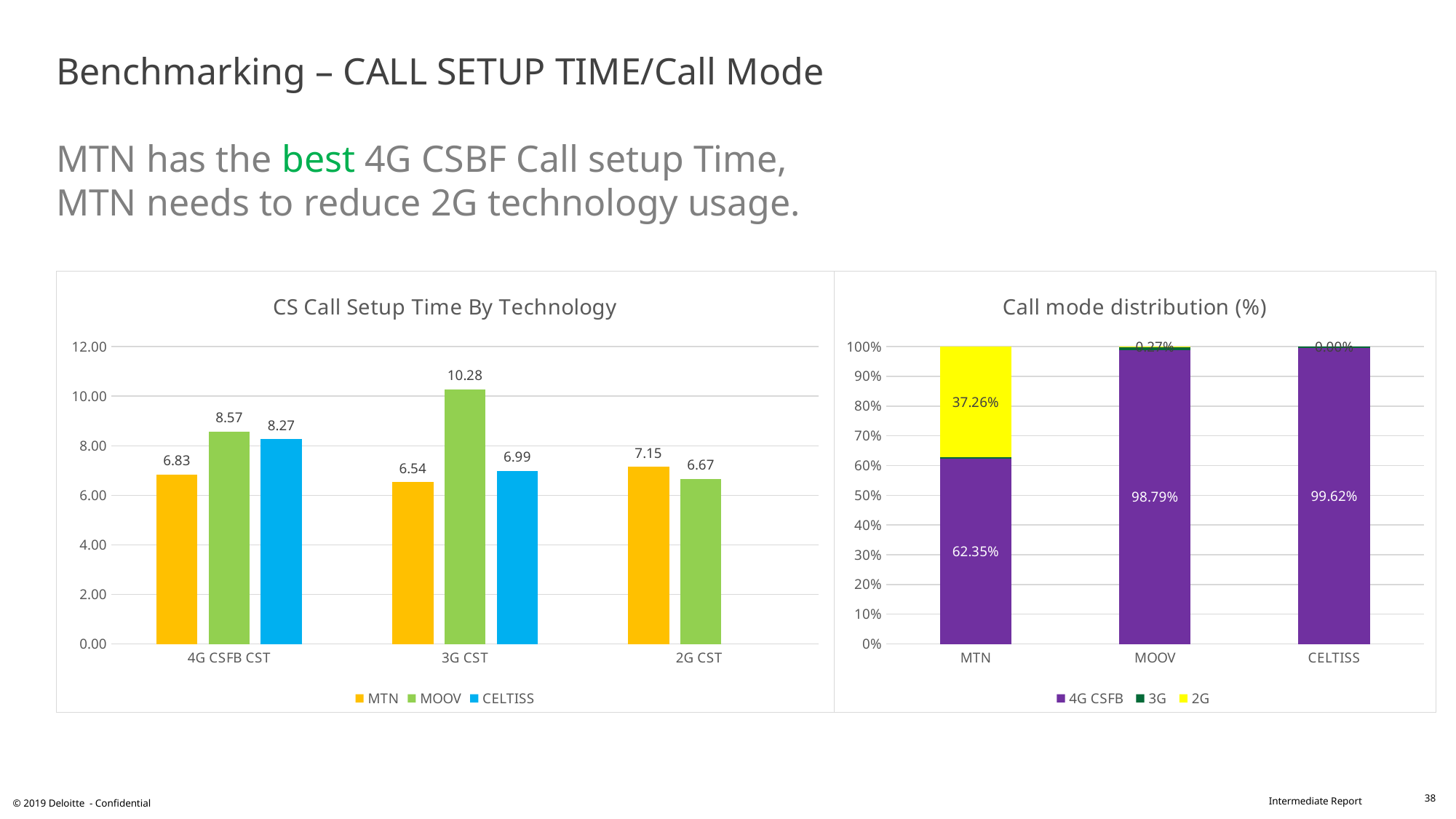
How many series does the legend of the 'CS Call Setup Time By Technology' chart list? 3 In the 'CS Call Setup Time By Technology' chart, which operator has the highest value in the 3G CST category? MOOV In the 'CS Call Setup Time By Technology' chart, which is larger in the 2G CST category: MTN or MOOV? MTN In the 'CS Call Setup Time By Technology' chart, what is the value for MTN in the 4G CSFB CST category? 6.83 In the 'CS Call Setup Time By Technology' chart, what is the value for CELTISS in the 4G CSFB CST category? 8.27 In the 'Call mode distribution (%)' chart, what is the 2G share for MTN? 37.26% In the 'CS Call Setup Time By Technology' chart, what is the value for MOOV in the 3G CST category? 10.28 What kind of chart is the 'Call mode distribution (%)' chart? Stacked bar chart In the 'Call mode distribution (%)' chart, what is the 4G CSFB share for MTN? 62.35% In the 'CS Call Setup Time By Technology' chart, what is the difference between the MOOV and MTN values in the 4G CSFB CST category? 1.74 In the 'CS Call Setup Time By Technology' chart, which operator has the lowest value in the 4G CSFB CST category? MTN In the 'Call mode distribution (%)' chart, which operator has the highest 4G CSFB share? CELTISS